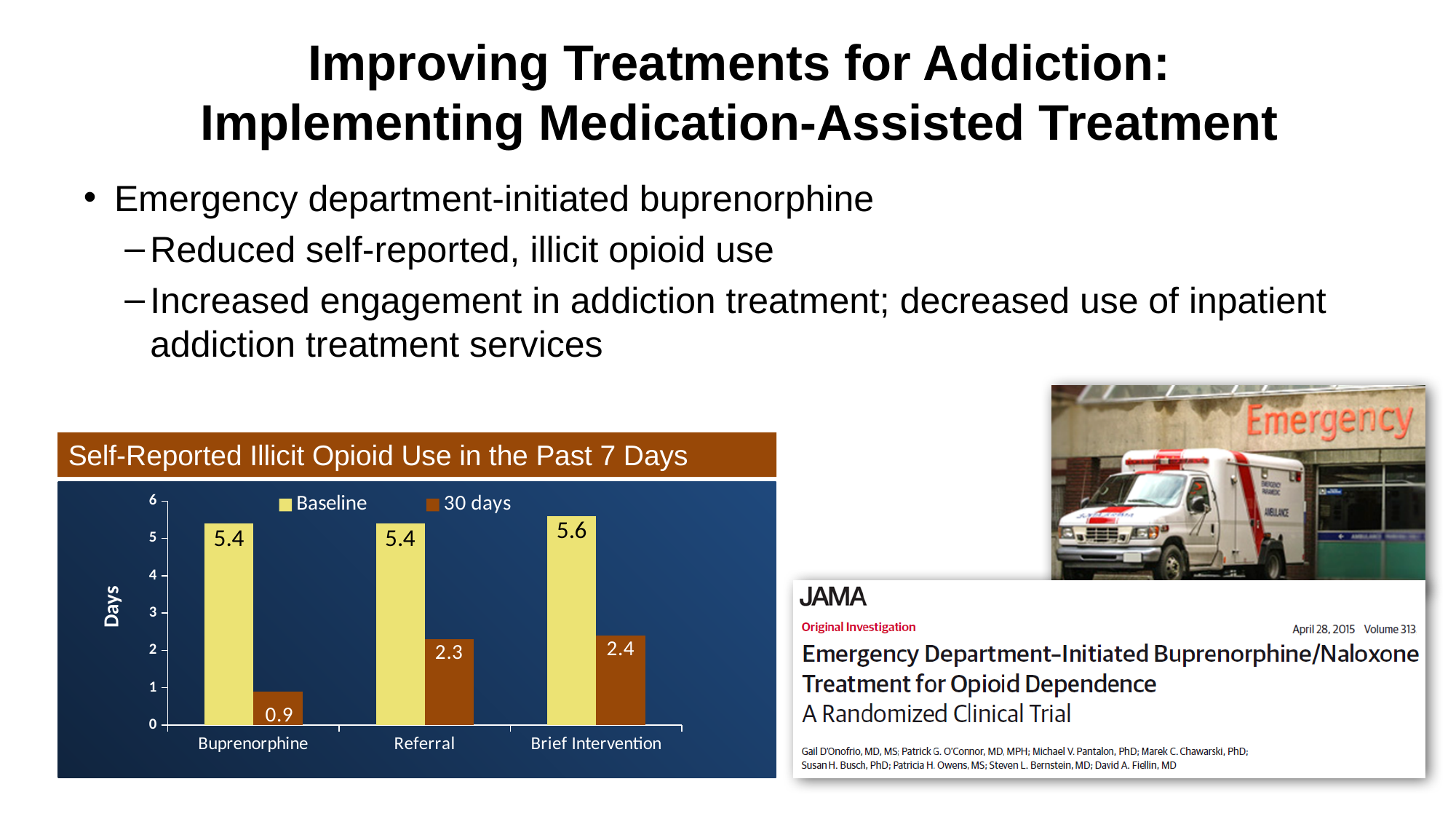
Which category has the highest Baseline value? Brief Intervention What is the title of the chart? Self-Reported Illicit Opioid Use in the Past 7 Days What is the difference between the 30 days values for Brief Intervention and Referral? 0.1 How many categories are shown on the x axis? 3 Which is larger, the 30 days value for Referral or the 30 days value for Buprenorphine? Referral How many series does the legend list? 2 What is the 30 days value for Referral? 2.3 What is the Baseline value for Brief Intervention? 5.6 What is the difference between the Baseline and 30 days values for Buprenorphine? 4.5 What is the Baseline value for Buprenorphine? 5.4 Which category has the lowest 30 days value? Buprenorphine What is the 30 days value for Buprenorphine? 0.9